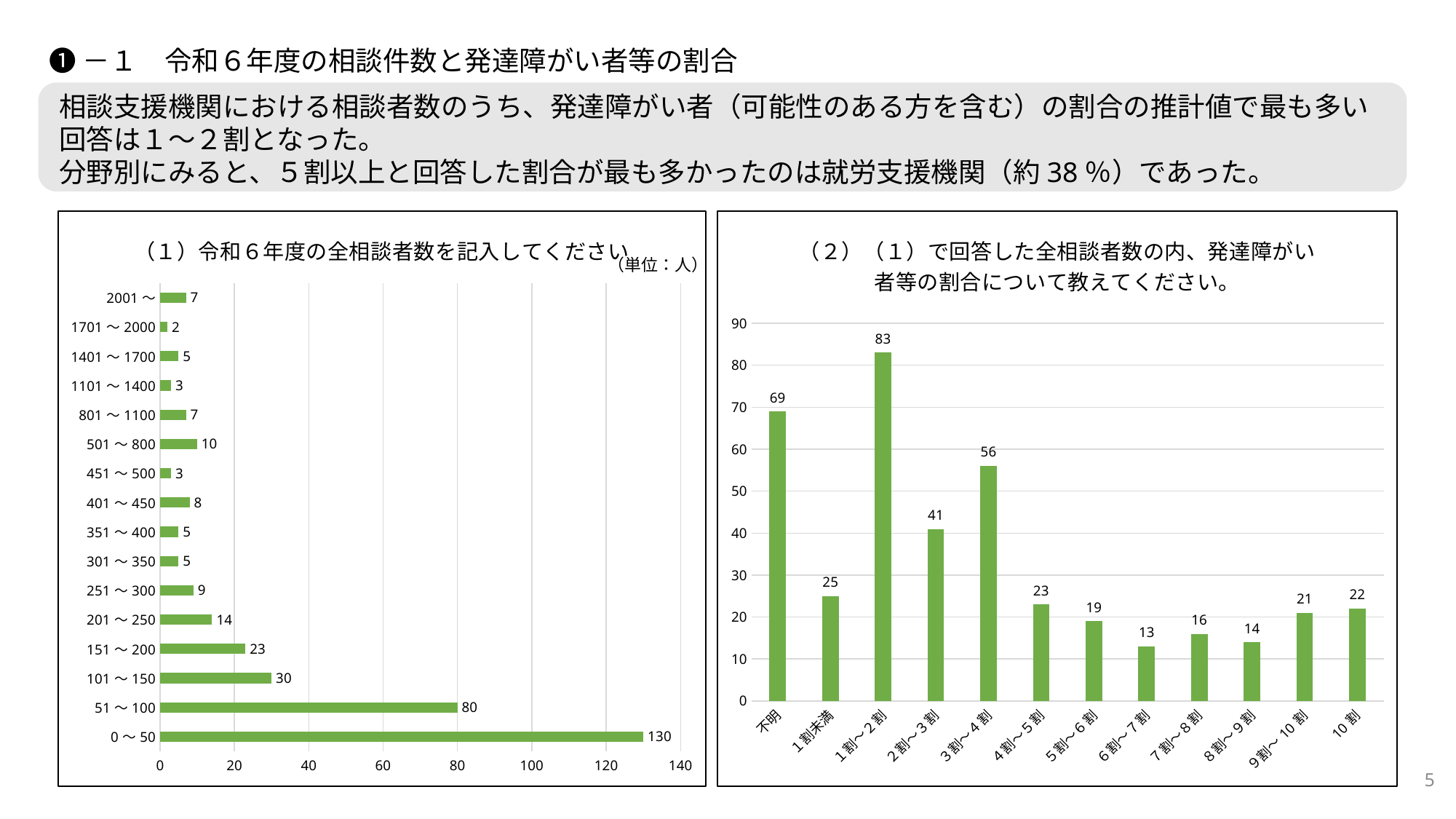
In the right chart (2), which category has the lowest value? 6割～7割 In the left chart (1), which category has the lowest value? 1701～2000 In the left chart (1), what is the difference between the values for 51～100 and 101～150? 50 In the left chart (1), which is larger, the value for 201～250 or the value for 251～300? 201～250 In the right chart (2), which is larger, the value for 9割～10割 or the value for 10割? 10割 In the right chart (2), what is the difference between the values for 不明 and 1割未満? 44 In the left chart (1), how many categories are shown? 16 In the left chart (1), what is the value for the 0～50 category? 130 In the right chart (2), which category has the highest value? 1割～2割 In the right chart (2), how many categories are shown on the x axis? 12 What kind of chart is the left chart (1)? bar chart In the right chart (2), what is the value for 3割～4割? 56